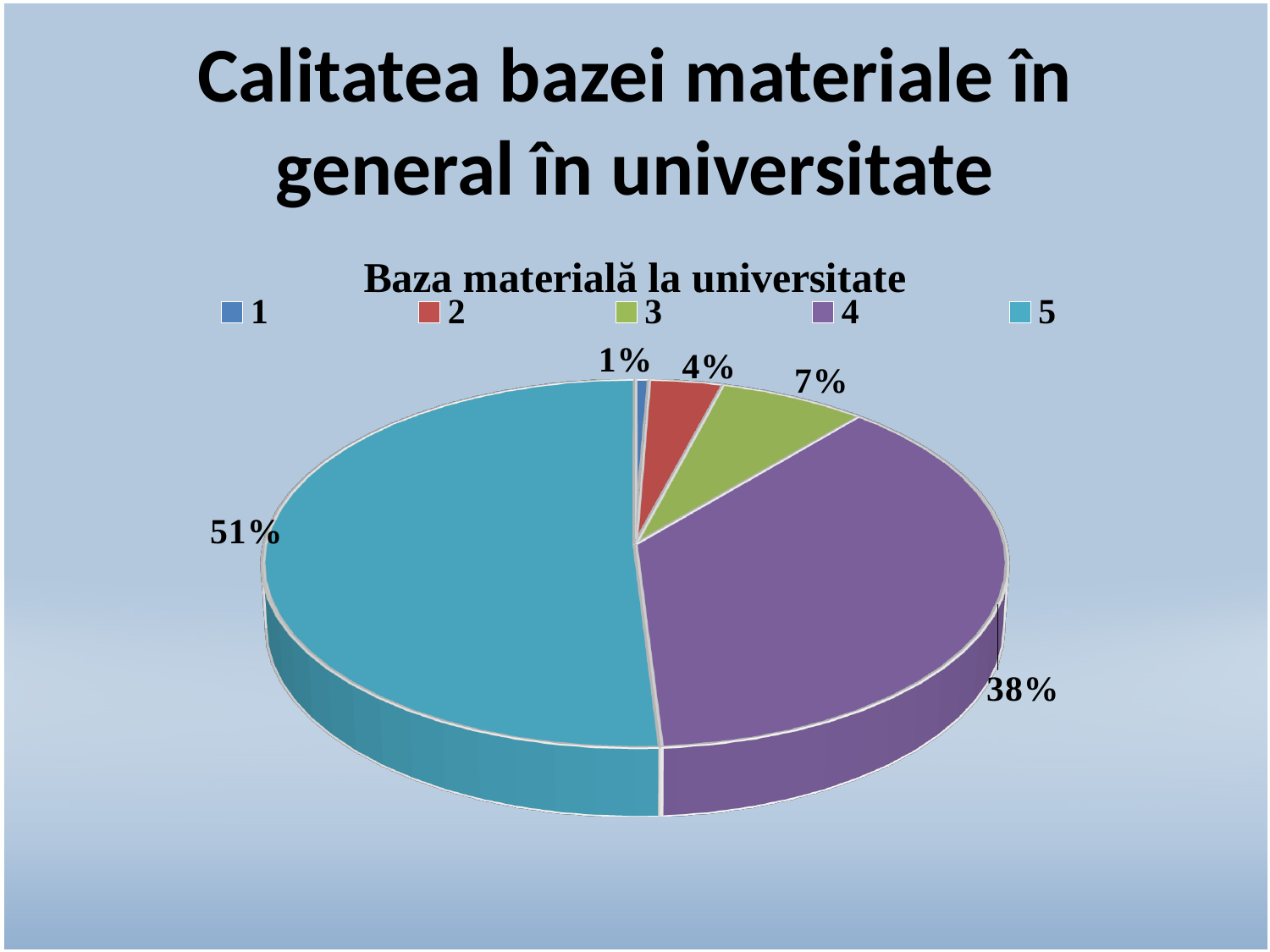
What kind of chart is shown on the slide? Pie chart What is the value shown for category 2? 4% What is the difference between the shares of category 5 and category 4? 13% What is the value shown for category 3? 7% What is the value shown for category 1? 1% Which is larger, the share for category 3 or the share for category 2? 3 Which category has the largest slice of the pie? 5 Which category has the smallest slice of the pie? 1 How many categories does the pie chart show? 5 What share of the pie does category 4 have? 38% What is the title of the chart? Baza materială la universitate What share of the pie does category 5 have? 51%